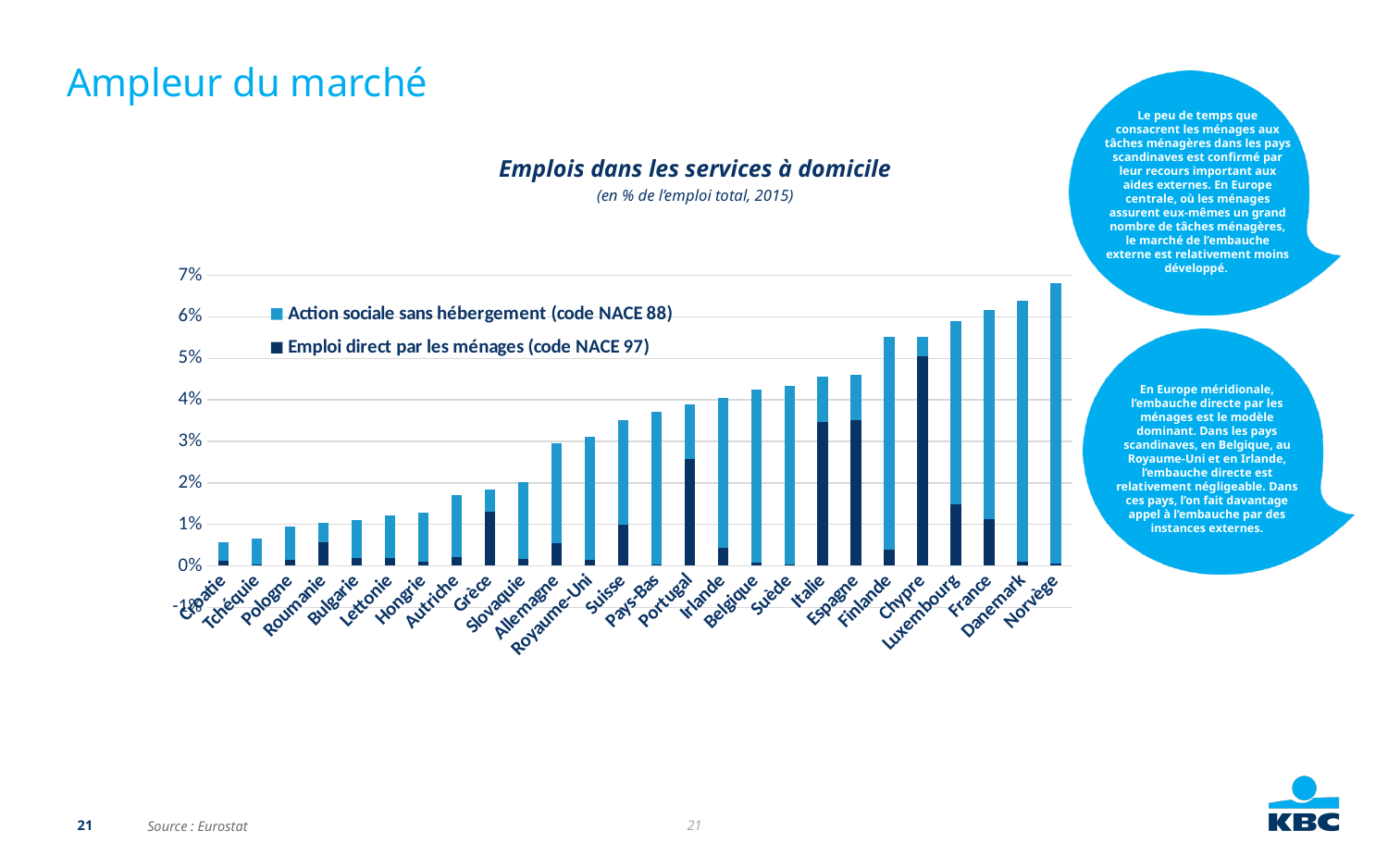
Which country has the highest total share of employment in home services? Norvège Which country has the lowest total share of employment in home services? Croatie Which country has the larger 'Emploi direct par les ménages (code NACE 97)' segment, Chypre or Italie? Chypre Is the total value for Norvège greater or less than 6%? greater Is the total value for Luxembourg greater or less than 5%? greater Is the 'Emploi direct par les ménages (code NACE 97)' value for Chypre greater or less than 4%? greater What is the title of the chart? Emplois dans les services à domicile How many series does the legend list? 2 What kind of chart is shown on the slide? Stacked bar chart Do the total values rise or fall moving from left to right along the x axis? Rise How many countries are shown on the x axis? 26